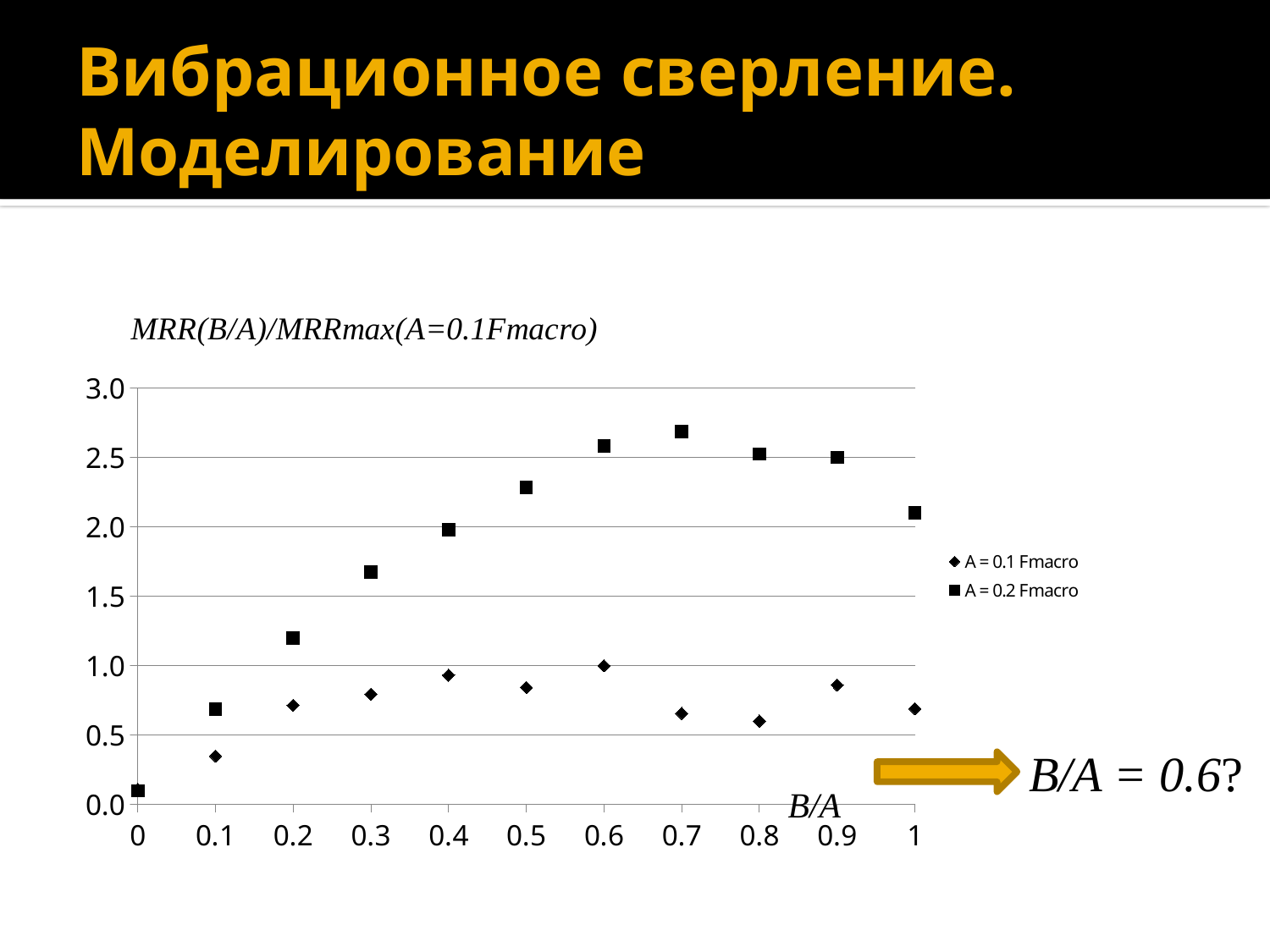
At which B/A value does the A = 0.2 Fmacro series reach its highest point? 0.7 Is the value of the A = 0.1 Fmacro series at B/A = 0.8 greater or less than 1.0? less How many series does the legend list? 2 Does the A = 0.2 Fmacro series rise or fall as B/A goes from 0 to 0.7? rise What kind of chart is shown on the slide? scatter chart What is the title of the chart? MRR(B/A)/MRRmax(A=0.1Fmacro) Is the value of the A = 0.1 Fmacro series at B/A = 0.1 greater or less than 0.5? less How many B/A values are plotted for each series? 11 Which series has the higher value at B/A = 0.5? A = 0.2 Fmacro Is the value of the A = 0.2 Fmacro series at B/A = 0.5 greater or less than 2.0? greater What is the label of the x axis? B/A